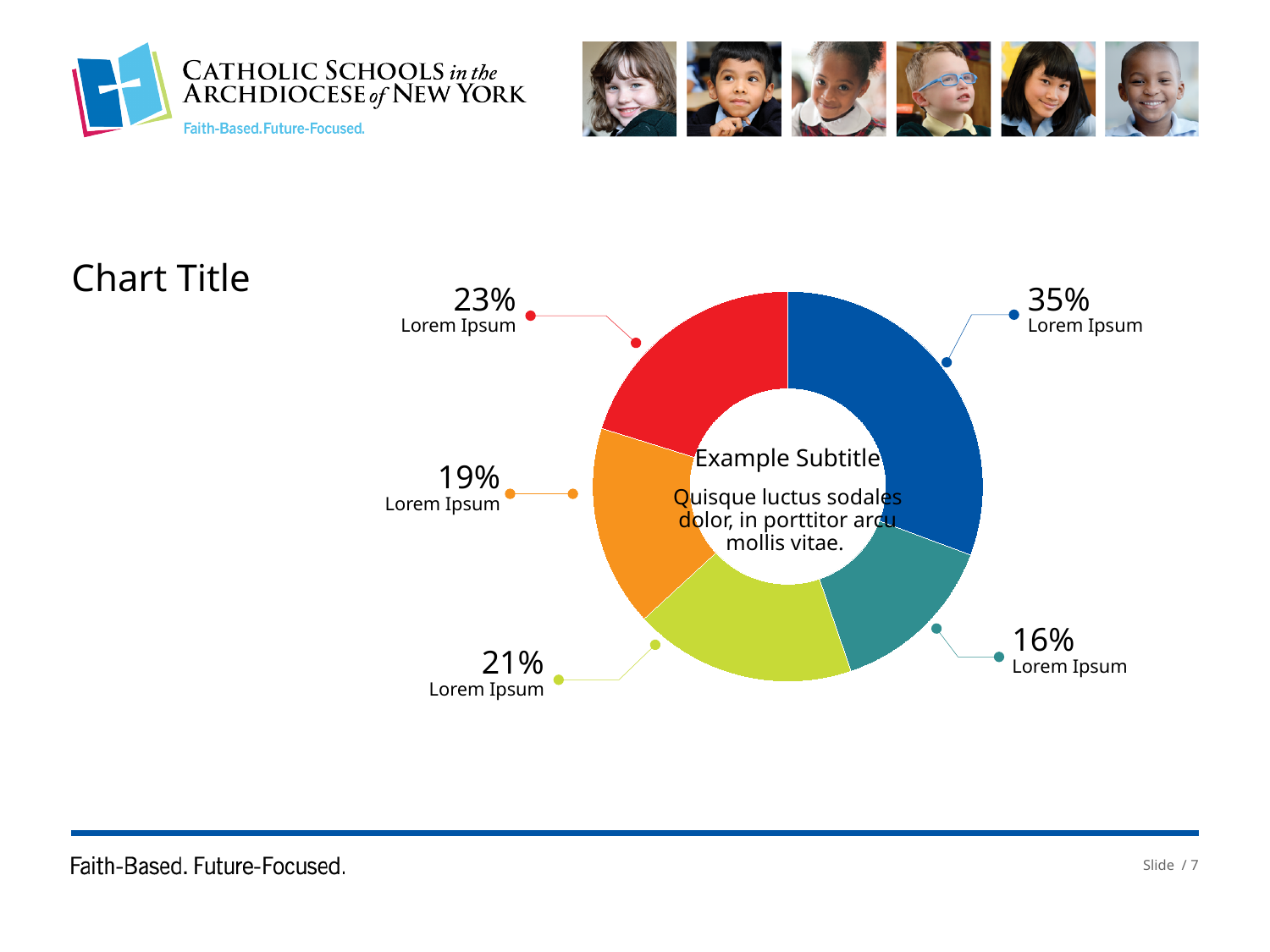
Which is larger, the red slice or the orange slice? the red slice (23%) What percentage is shown for the blue slice of the donut chart? 35% Which slice of the donut chart has the smallest share? the teal slice (16%) What percentage is shown for the lime green slice of the donut chart? 21% What percentage is shown for the orange slice of the donut chart? 19% What percentage is shown for the red slice of the donut chart? 23% What percentage is shown for the teal slice of the donut chart? 16% What kind of chart is shown on the slide? donut chart What text appears in the centre of the donut chart as its subtitle? Example Subtitle How many slices does the donut chart have? 5 Which slice of the donut chart has the largest share? the blue slice (35%) What is the difference in percentage points between the largest slice (35%) and the smallest slice (16%)? 19 percentage points